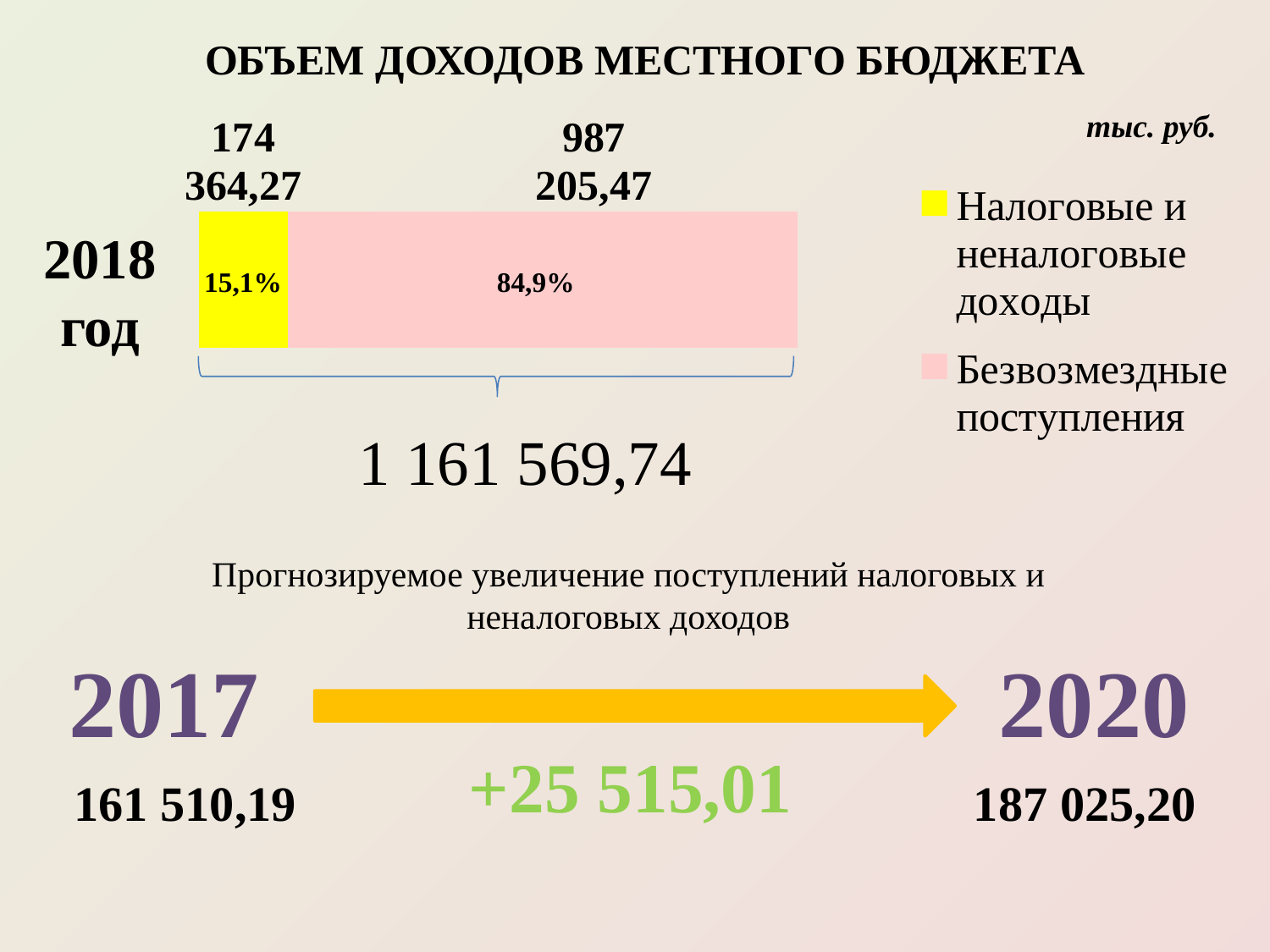
What is the difference between the 'Безвозмездные поступления' and 'Налоговые и неналоговые доходы' values in the 2018 bar? 812 841,20 What is the value of the 'Безвозмездные поступления' segment in the 2018 bar? 987 205,47 How many series does the legend of the chart list? 2 What is the total of the stacked 2018 bar? 1 161 569,74 What colour represents 'Налоговые и неналоговые доходы' in the chart? Yellow What percentage share of the 2018 bar is 'Налоговые и неналоговые доходы'? 15,1% Which segment of the 2018 bar has the largest value? Безвозмездные поступления Which segment of the 2018 bar has the smallest value? Налоговые и неналоговые доходы What type of chart is shown for 2018? Stacked bar chart What percentage share of the 2018 bar is 'Безвозмездные поступления'? 84,9% What is the value of the 'Налоговые и неналоговые доходы' segment in the 2018 bar? 174 364,27 Which segment of the 2018 bar is larger, 'Налоговые и неналоговые доходы' or 'Безвозмездные поступления'? Безвозмездные поступления